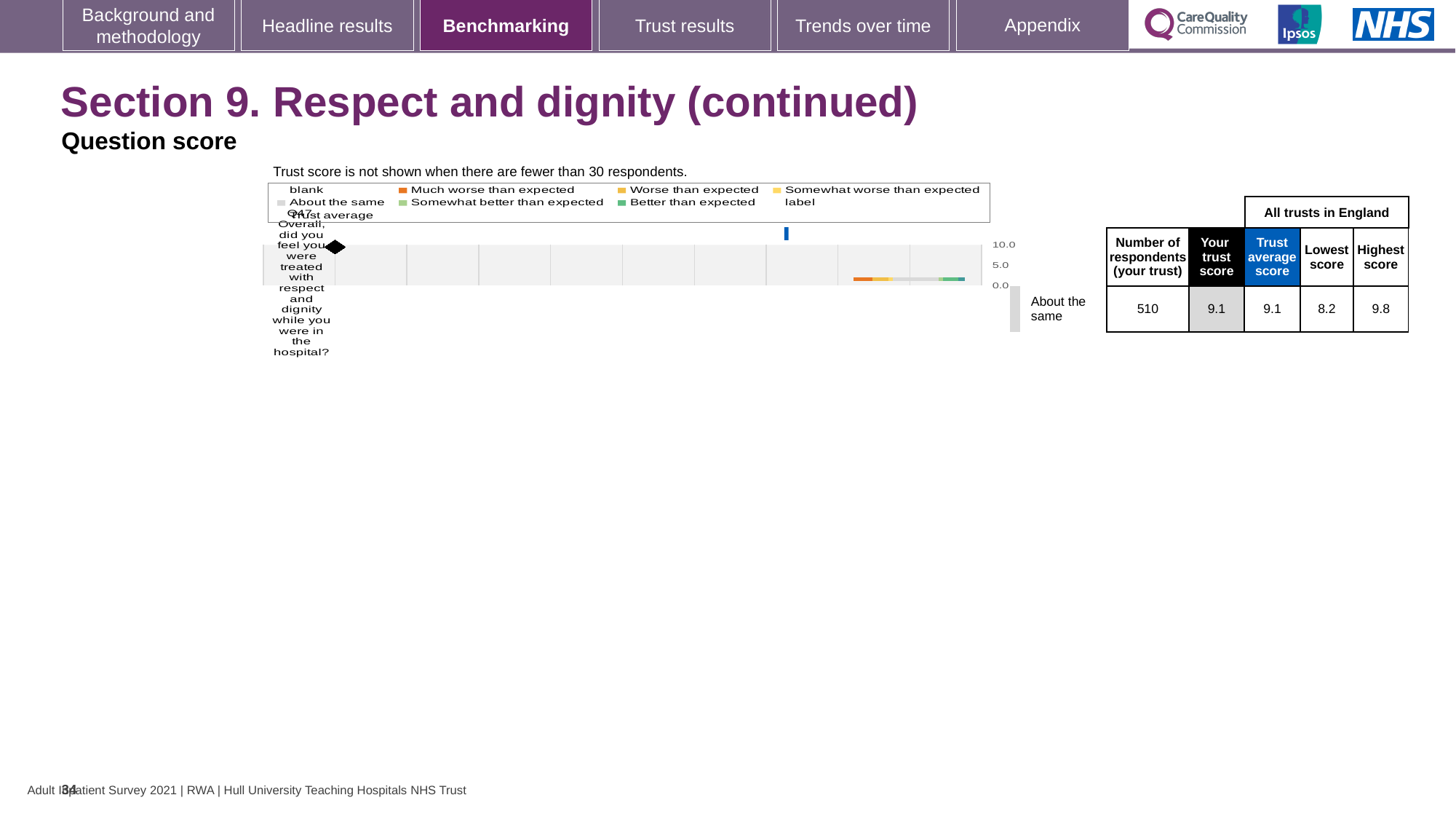
What is the trust score for Q47 (Your trust score)? 9.1 Is the trust score for Q47 higher than, lower than, or the same as the trust average score? the same How many survey questions are plotted on the chart? 1 What colour does the legend use for 'Much worse than expected'? orange Is the trust score for Q47 greater or less than 5.0 on the chart's axis? greater What is the lowest score for Q47 among all trusts in England? 8.2 What is the trust average score for Q47 across all trusts in England? 9.1 How many respondents from the trust answered Q47? 510 Which benchmarking category is Q47 placed in for this trust? About the same What is the difference between the highest score and the lowest score for Q47? 1.6 What kind of chart is shown on the slide? bar chart What is the highest score for Q47 among all trusts in England? 9.8